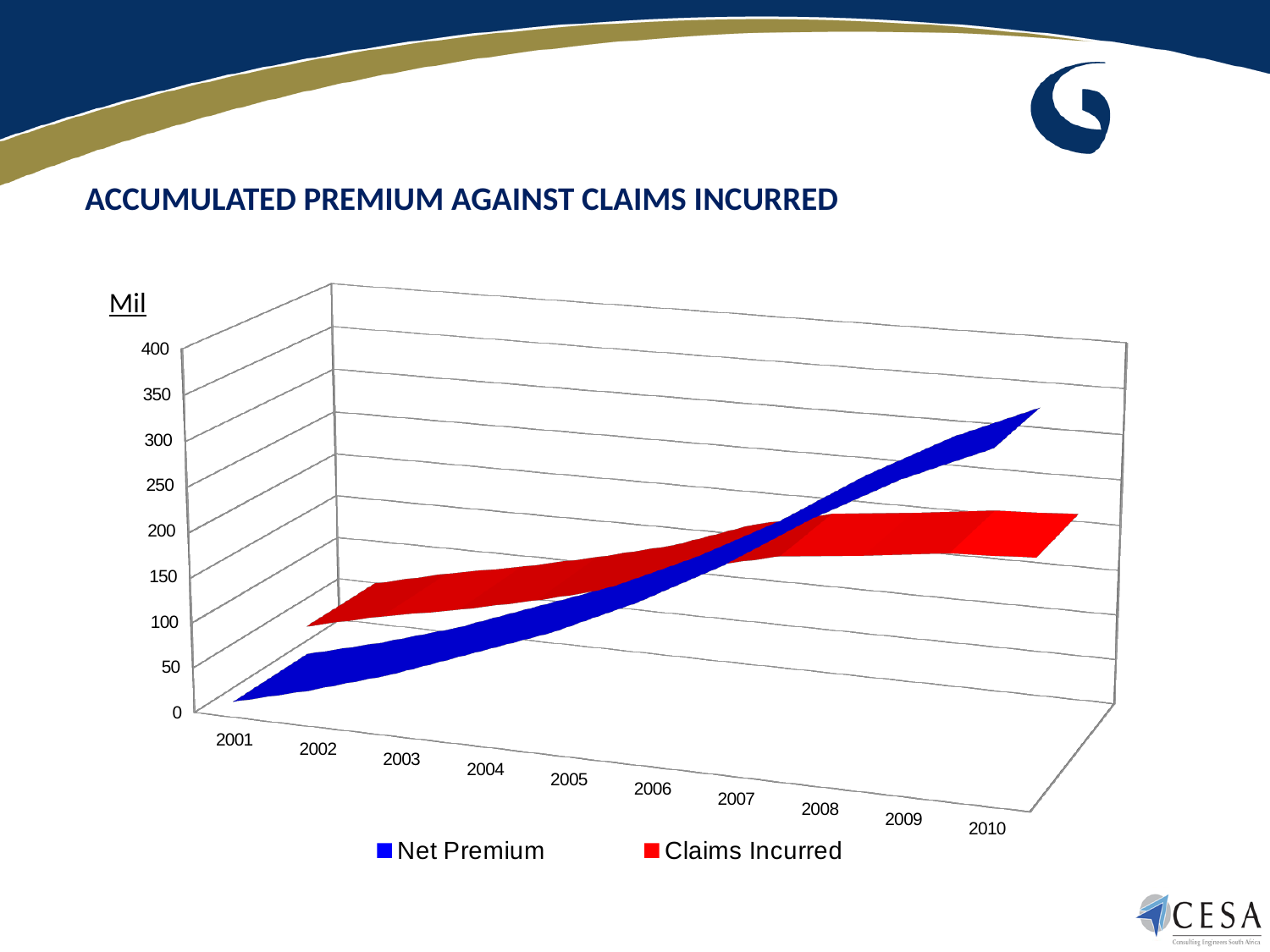
Is the value for Net Premium in 2001 greater or less than 50? less Which colour represents Net Premium in the legend? blue Which series is higher in 2001, Net Premium or Claims Incurred? Claims Incurred How many years are shown on the x axis? 10 In which year is Net Premium at its lowest? 2001 Is the value for Net Premium in 2010 greater or less than 200? greater How many series does the legend list? 2 What kind of chart is shown on the slide? line chart In which year is Net Premium at its highest? 2010 Which series is higher in 2010, Net Premium or Claims Incurred? Net Premium What is the title of the chart? ACCUMULATED PREMIUM AGAINST CLAIMS INCURRED Does Net Premium rise or fall from 2001 to 2010? rise